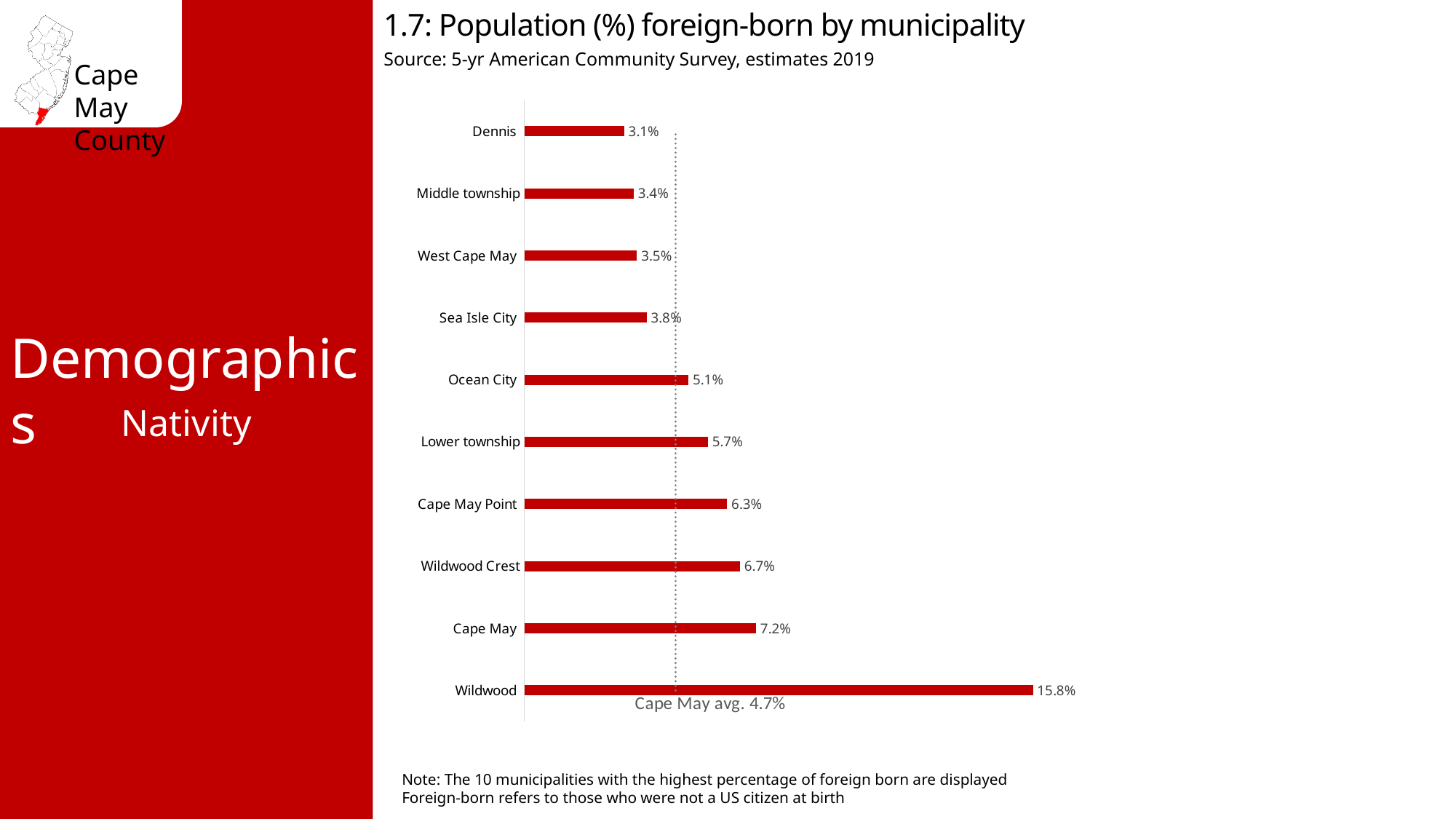
Which municipality has the highest percentage of foreign-born population? Wildwood What is the percentage of foreign-born population in Wildwood? 15.8% What is the source of the data shown in the chart? 5-yr American Community Survey, estimates 2019 What is the percentage of foreign-born population in Ocean City? 5.1% What is the difference in foreign-born percentage between Wildwood and Cape May? 8.6% What type of chart is used to show the foreign-born population by municipality? Bar chart Which municipality has the lowest percentage of foreign-born population? Dennis Which has a higher foreign-born percentage, Cape May Point or Sea Isle City? Cape May Point What is the difference in foreign-born percentage between Wildwood Crest and Lower township? 1.0% How many municipalities are shown in the chart? 10 What is the percentage of foreign-born population in Dennis? 3.1% What is the Cape May average foreign-born percentage marked by the dotted line? 4.7%